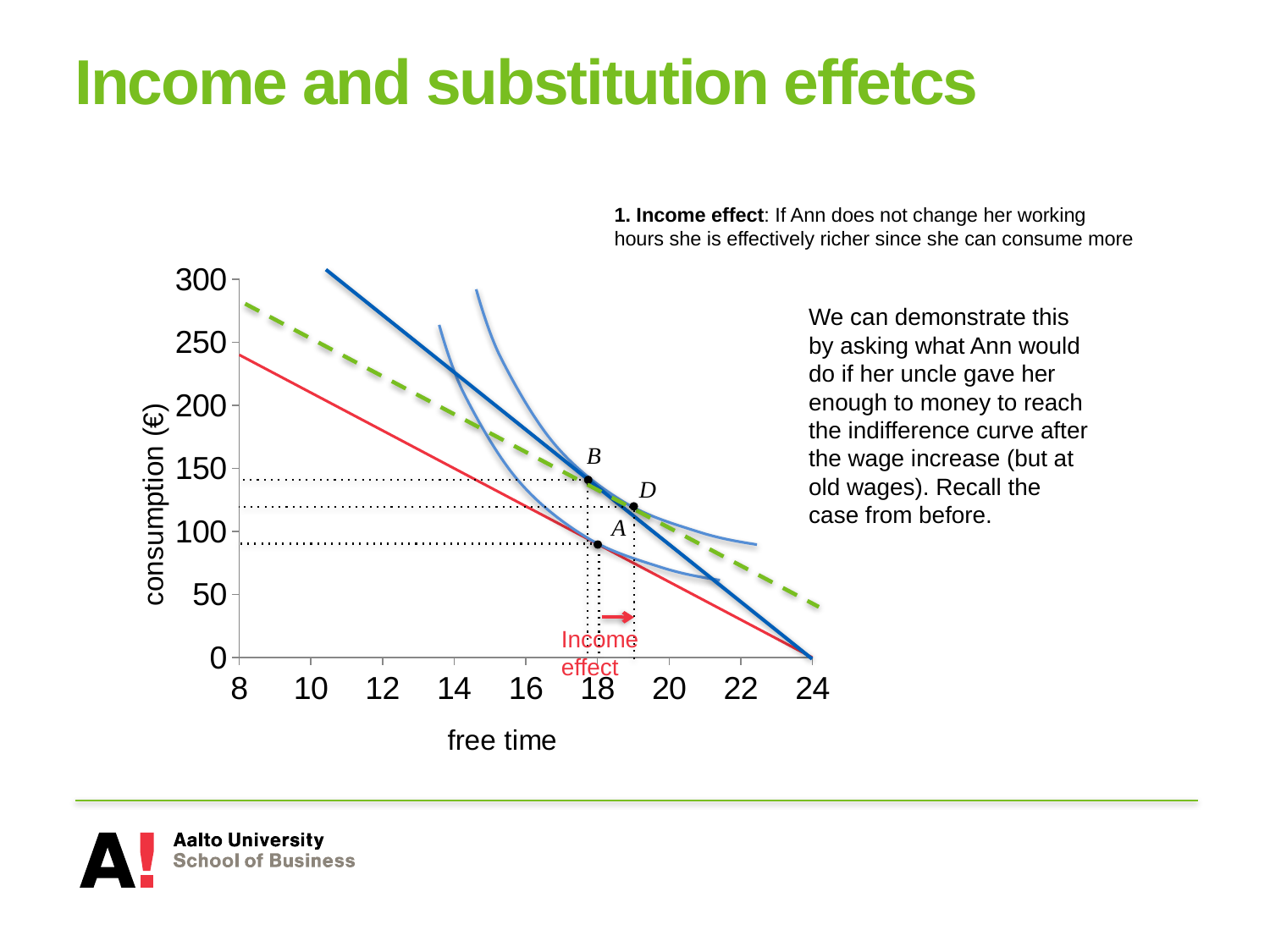
Is the consumption at point A greater or less than 150? less At what free time value do the red and blue budget lines meet the horizontal axis? 24 What is the label of the vertical axis of the chart? consumption (€) Is the free time at point D greater or less than 18? greater Which point has higher consumption, B or D? B Which point has higher consumption, A or D? D What kind of chart is shown on the slide? line chart What is the label of the horizontal axis of the chart? free time Is the consumption at point B greater or less than 100? greater How many labelled points (A, B, D) are marked on the chart? 3 Which labelled point has the lowest consumption? A Which labelled point has the highest consumption? B